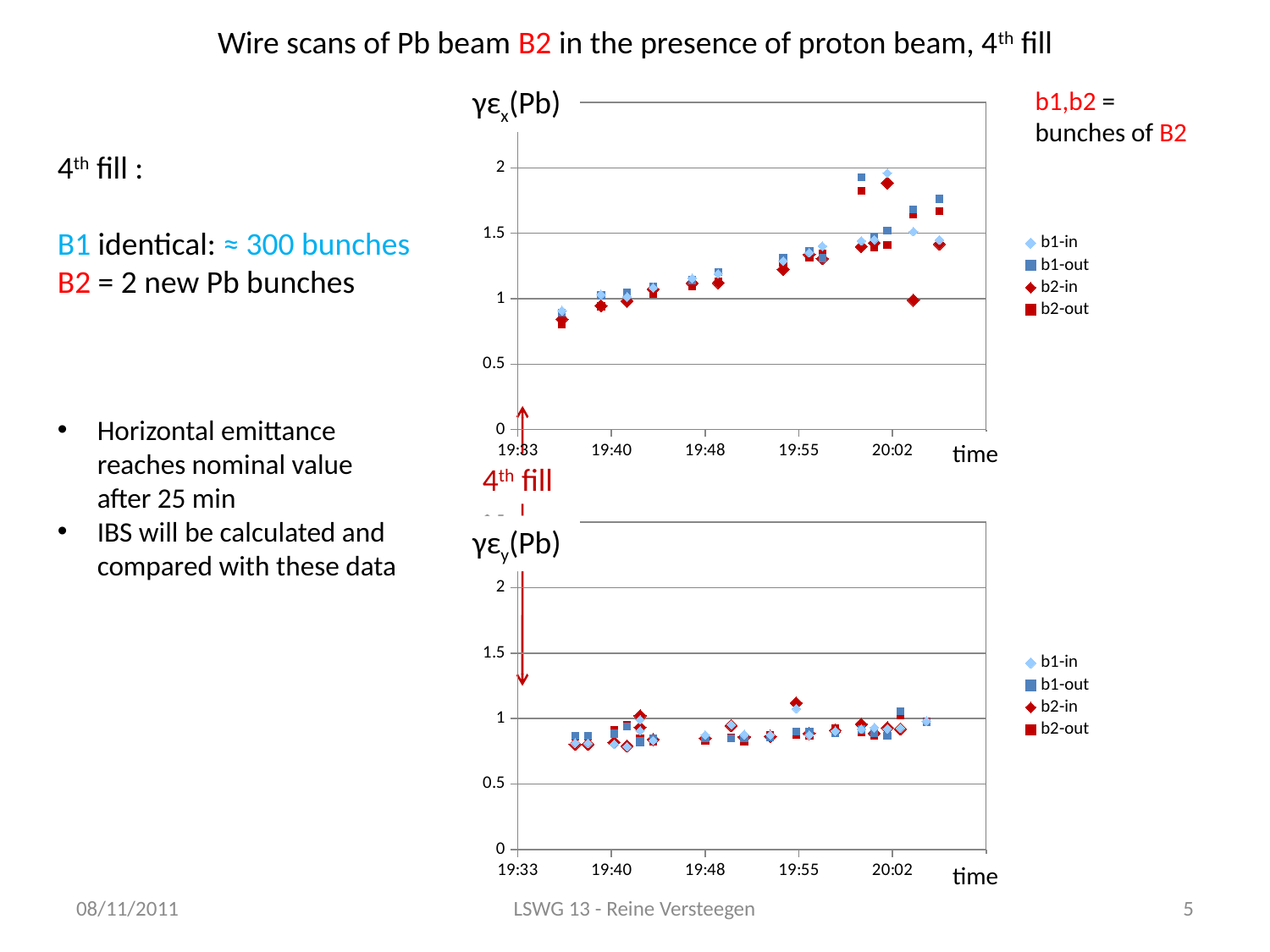
In the top chart (γεx(Pb)), how many series does the legend list? 4 In the bottom chart (γεy(Pb)), is the highest b2-in value greater or less than 1.5? less In the top chart (γεx(Pb)), are the values at the earliest time (around 19:36) greater or less than 1? less In the top chart (γεx(Pb)), what is the highest value shown on the y axis? 2 What are the names of the series listed in the legend of the top chart (γεx(Pb))? b1-in, b1-out, b2-in, b2-out What is the label on the x axis of the bottom chart (γεy(Pb))? time In the top chart (γεx(Pb)), is the highest b1-in value greater or less than 1.5? greater In the bottom chart (γεy(Pb)), how many series does the legend list? 4 What kind of chart is the top chart (γεx(Pb))? scatter chart In the top chart (γεx(Pb)), do the values generally rise or fall as time increases along the x axis? rise